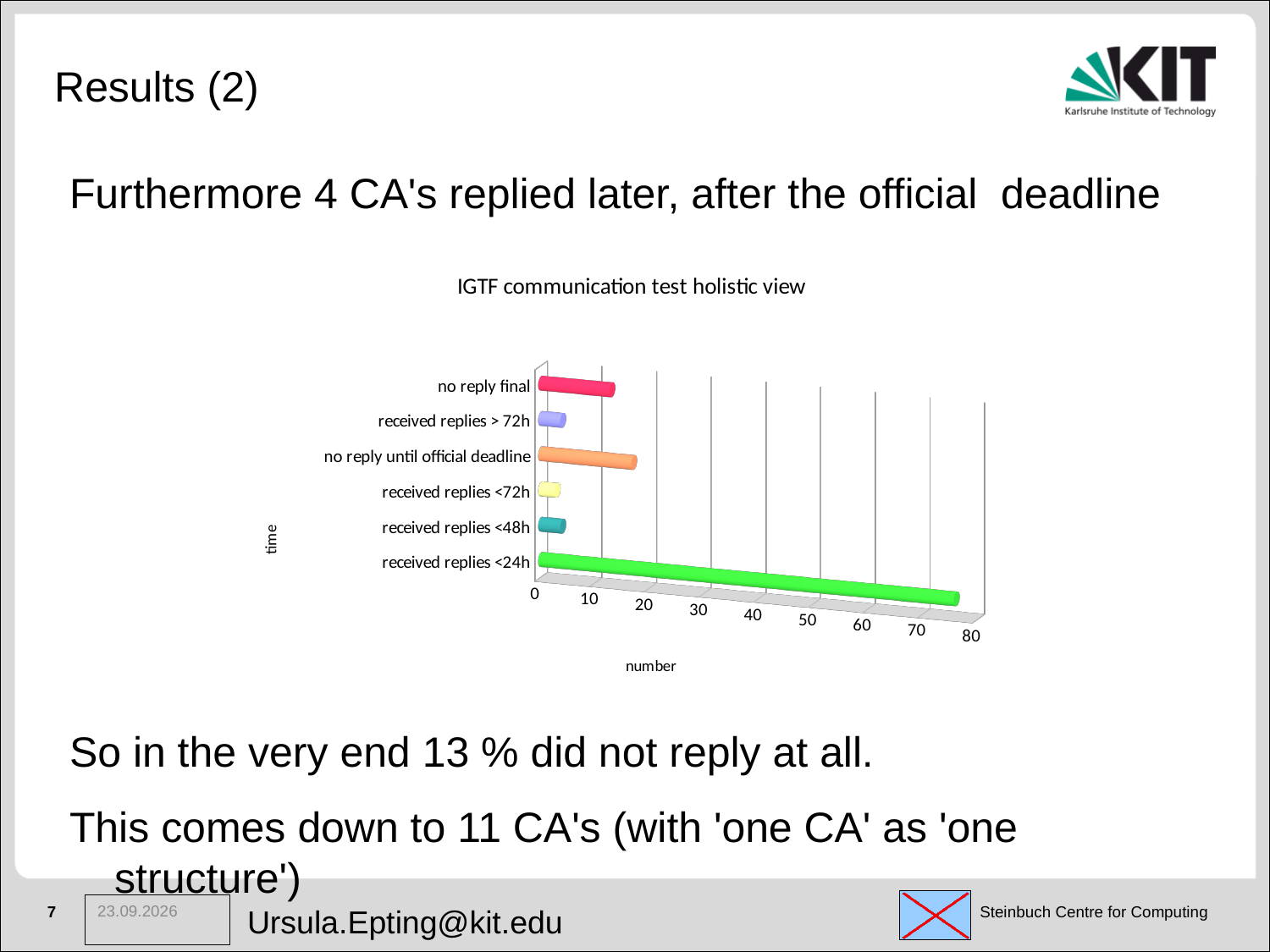
Which is larger: the value for 'received replies <24h' or the value for 'no reply final'? received replies <24h How many categories are plotted in the chart? 6 What kind of chart is shown on the slide? bar chart What is the title of the chart? IGTF communication test holistic view Is the value for 'received replies <48h' greater or less than 10? less What is the label of the horizontal (value) axis of the chart? number Which is larger: the value for 'no reply until official deadline' or the value for 'received replies <72h'? no reply until official deadline Is the value for 'received replies <72h' greater or less than 10? less Is the value for 'received replies > 72h' greater or less than 10? less Which category has the highest value in the chart? received replies <24h